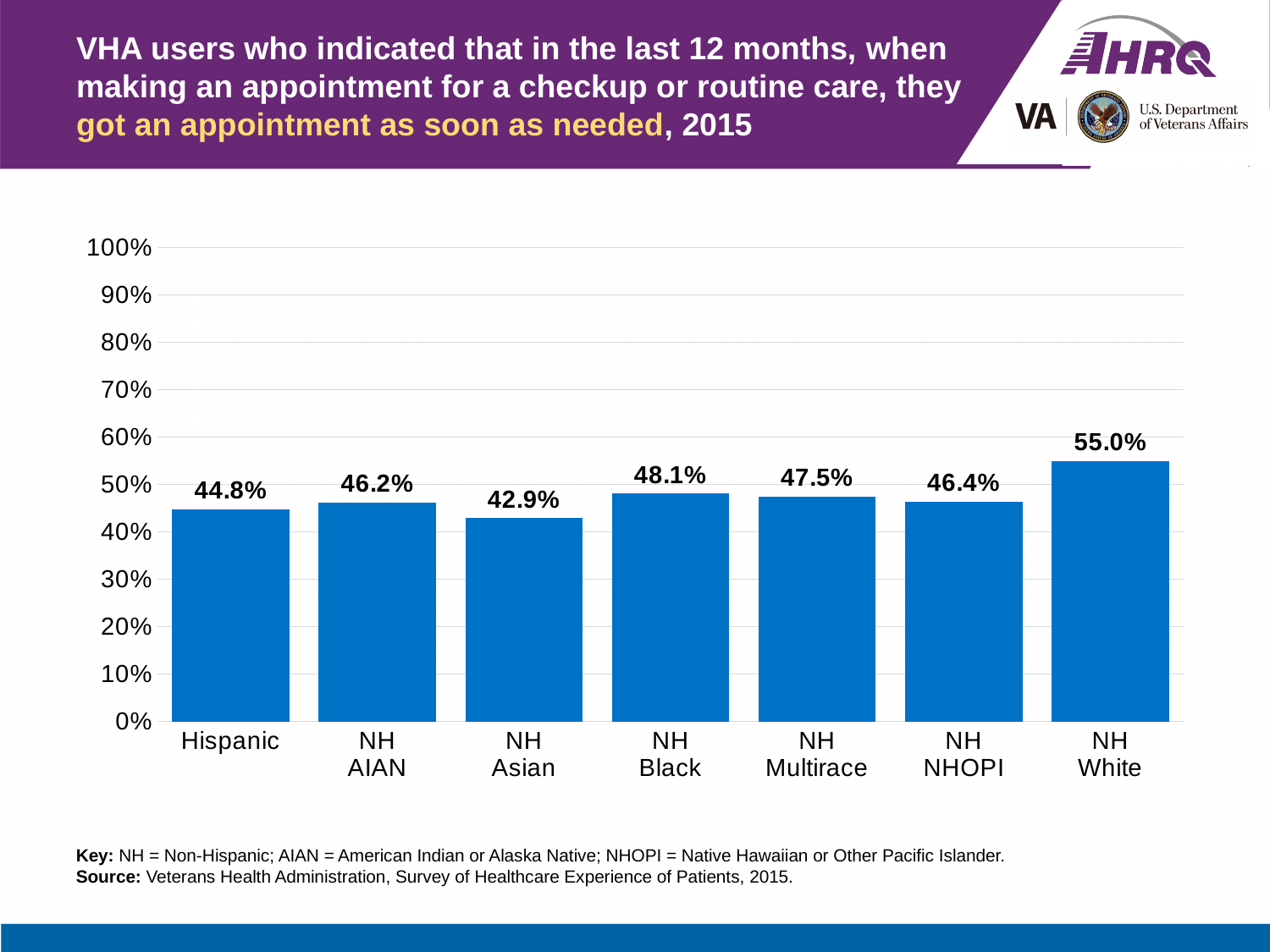
What kind of chart is shown on the slide? Bar chart Is the value for NH White greater or less than 50%? greater What is the value shown for NH NHOPI? 46.4% What is the value shown for NH Multirace? 47.5% Which group has the highest percentage? NH White What is the difference between the values for NH White and NH Asian? 12.1% What is the difference between the values for NH Black and Hispanic? 3.3% Which group has the lowest percentage? NH Asian Which is larger, the value for NH AIAN or the value for NH Asian? NH AIAN What percentage of Hispanic VHA users got an appointment as soon as needed? 44.8% What is the value shown for NH Black? 48.1% How many groups are shown on the x axis? 7